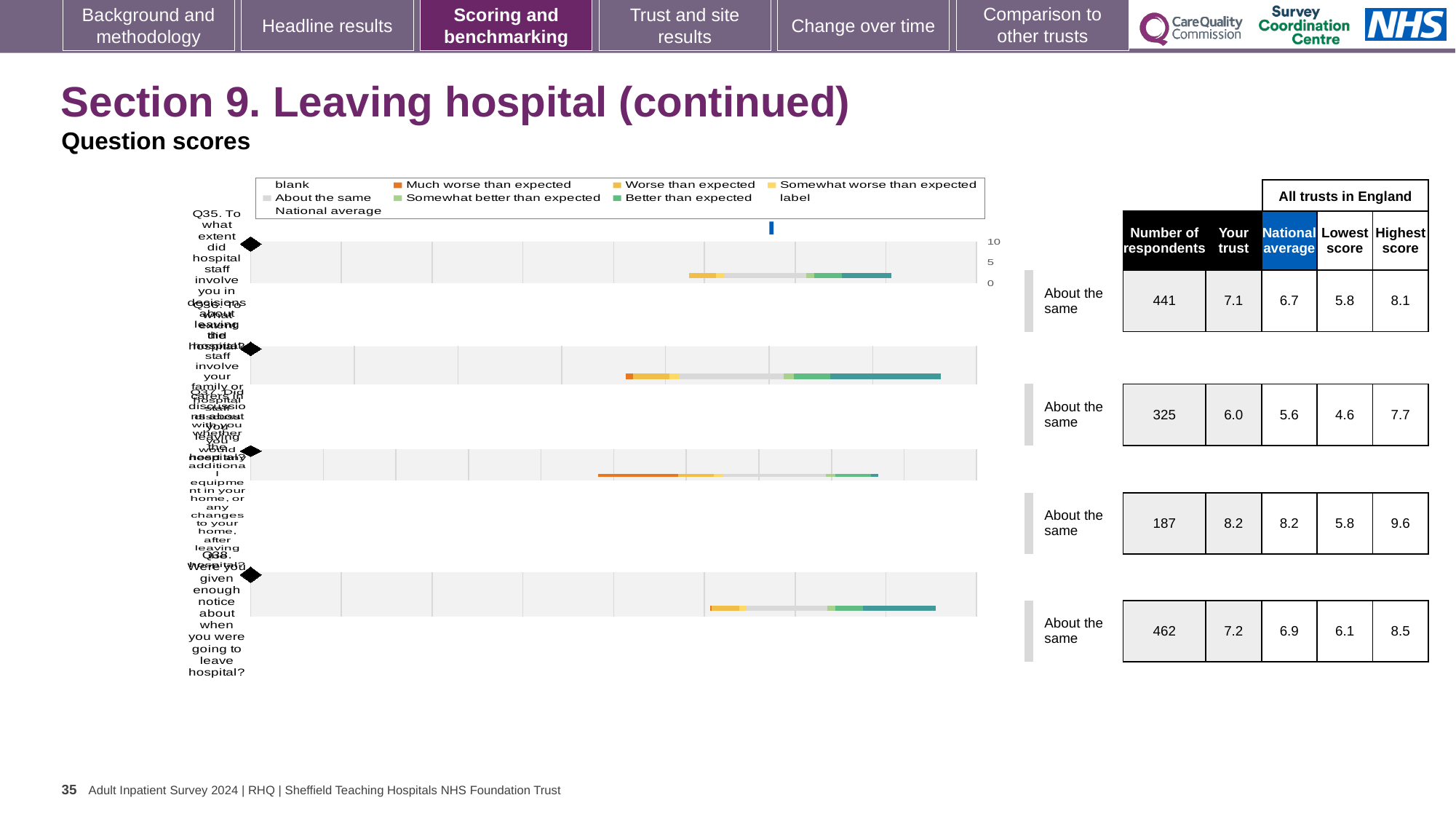
Which legend entry is shown in dark orange? Much worse than expected In the table next to the chart, what is the number of respondents for Q35? 441 In the table next to the chart, is the 'Your trust' score for Q38 larger than the national average for Q38? Yes, 7.2 vs 6.9 In the table next to the chart, which question has the lowest 'Your trust' score? Q36 In the table next to the chart, which question has the highest number of respondents? Q38 In the table next to the chart, what is the difference between the 'Your trust' score and the national average for Q35? 0.4 How many question bars are plotted in the chart? 4 In the table next to the chart, what is the national average for the second question (Q36)? 5.6 In the table next to the chart, what is the highest score for the third question (Q37)? 9.6 In the table next to the chart, what is the 'Your trust' score for Q38 (enough notice about leaving hospital)? 7.2 What kind of chart is shown on the slide? bar chart Which legend entry is shown in dark teal? Better than expected